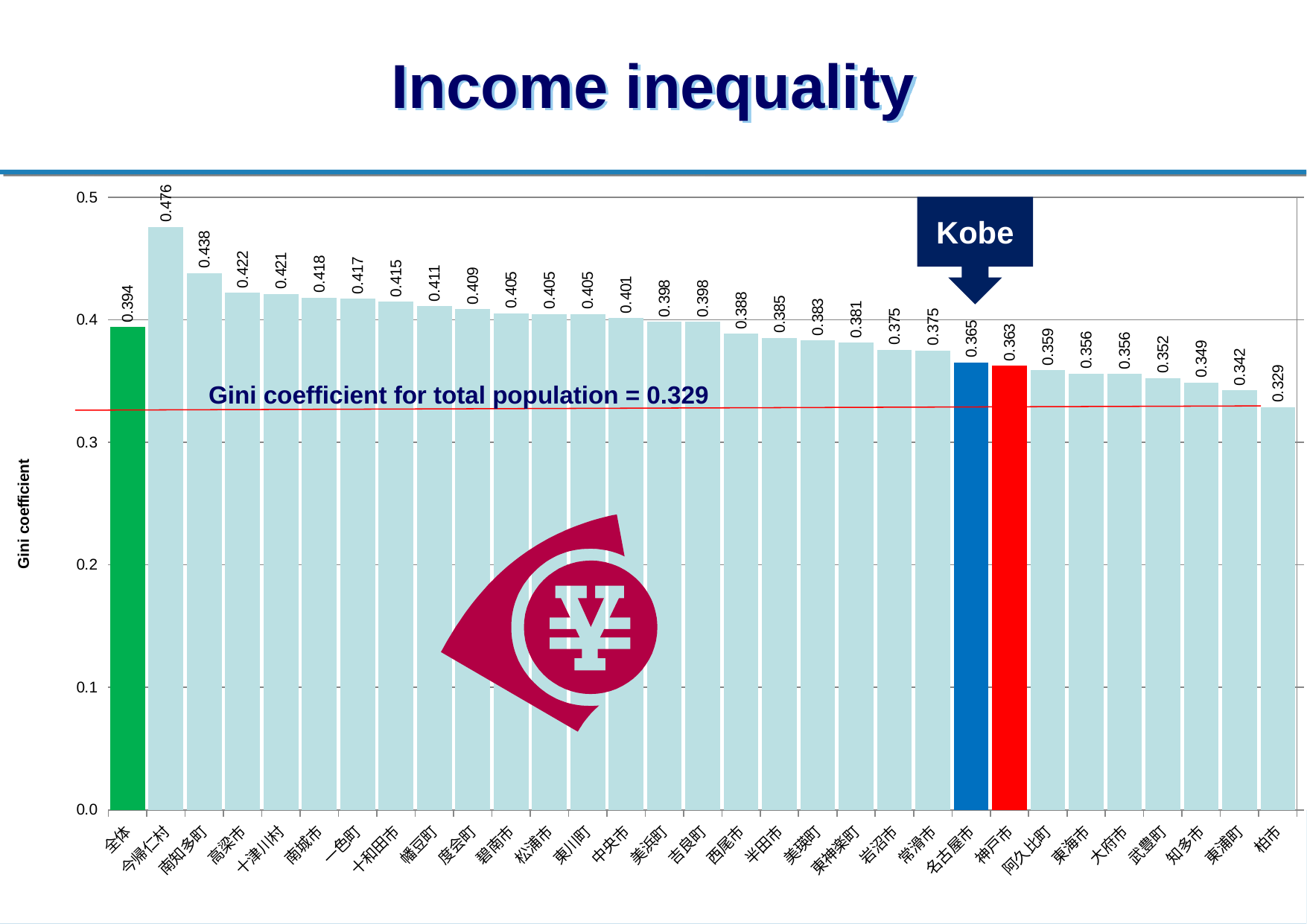
Which category has the highest Gini coefficient? 今帰仁村 What is the Gini coefficient shown for 神戸市 (Kobe)? 0.363 What is the Gini coefficient shown for 全体? 0.394 What is the difference between the Gini coefficient of 今帰仁村 and that of 柏市? 0.147 How many bars are plotted in the chart? 31 What is the Gini coefficient shown for 名古屋市? 0.365 What value does the red horizontal line labelled 'Gini coefficient for total population' mark? 0.329 What kind of chart is shown on the slide? Bar chart Which category has the lowest Gini coefficient? 柏市 Excluding the first bar (全体), do the Gini coefficients rise or fall from left to right across the chart? Fall Which has a higher Gini coefficient, 名古屋市 or 神戸市? 名古屋市 What is the difference between the Gini coefficient of 全体 and that of 神戸市? 0.031